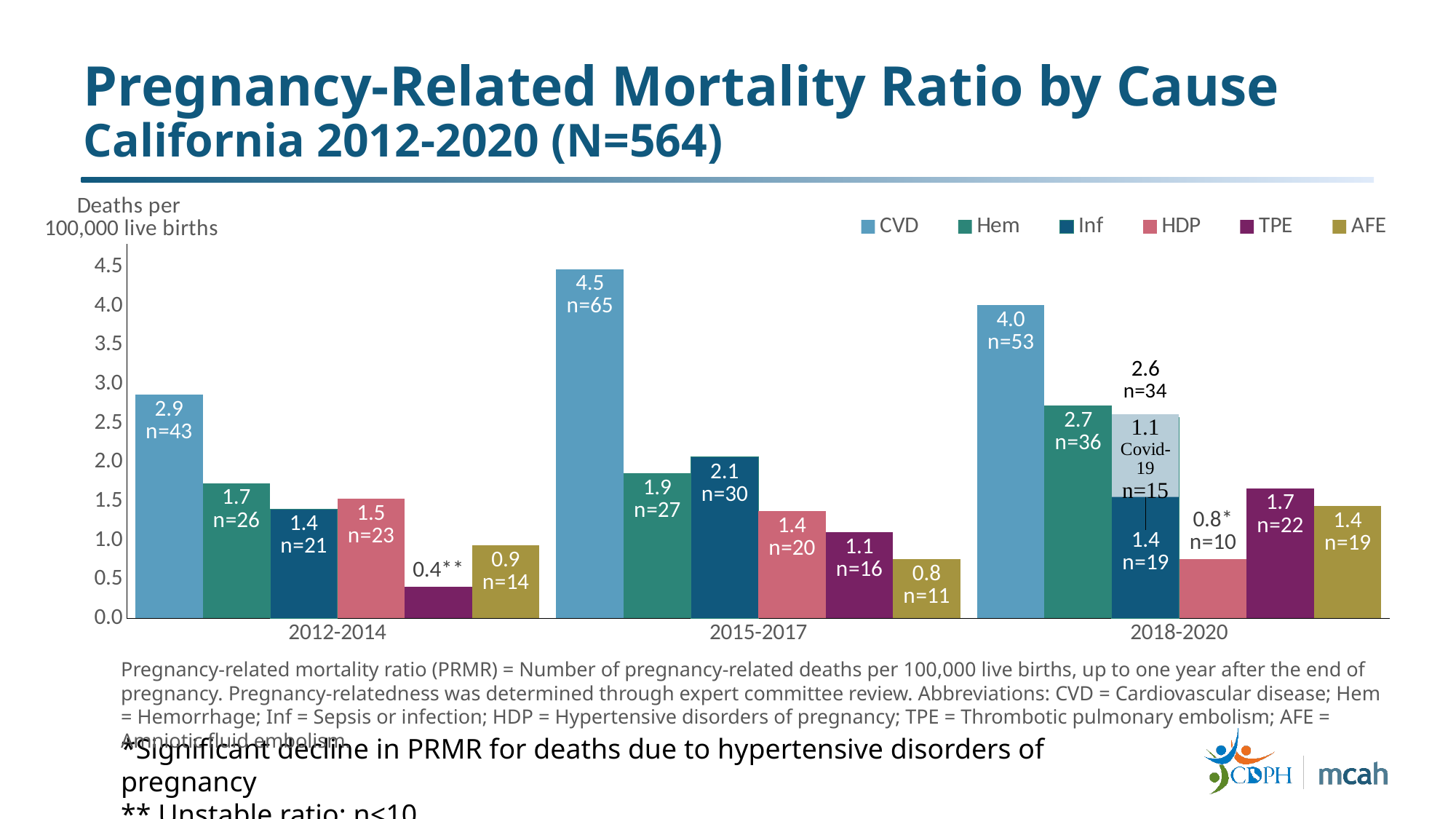
How many series does the legend list? 6 What is the y-axis label of the chart? Deaths per 100,000 live births How many deaths (n) are shown for HDP in 2012-2014? n=23 What is the difference between the CVD values for 2015-2017 and 2018-2020? 0.5 What is the pregnancy-related mortality ratio for CVD in 2015-2017? 4.5 What is the Covid-19 portion of the Inf bar in 2018-2020? 1.1 What kind of chart is shown on the slide? Bar chart How many time periods are shown on the x axis? 3 What is the value for Hem in 2018-2020? 2.7 In 2015-2017, which is larger, the value for Inf or the value for Hem? Inf Which cause has the lowest mortality ratio in 2012-2014? TPE Which cause has the highest mortality ratio in 2015-2017? CVD